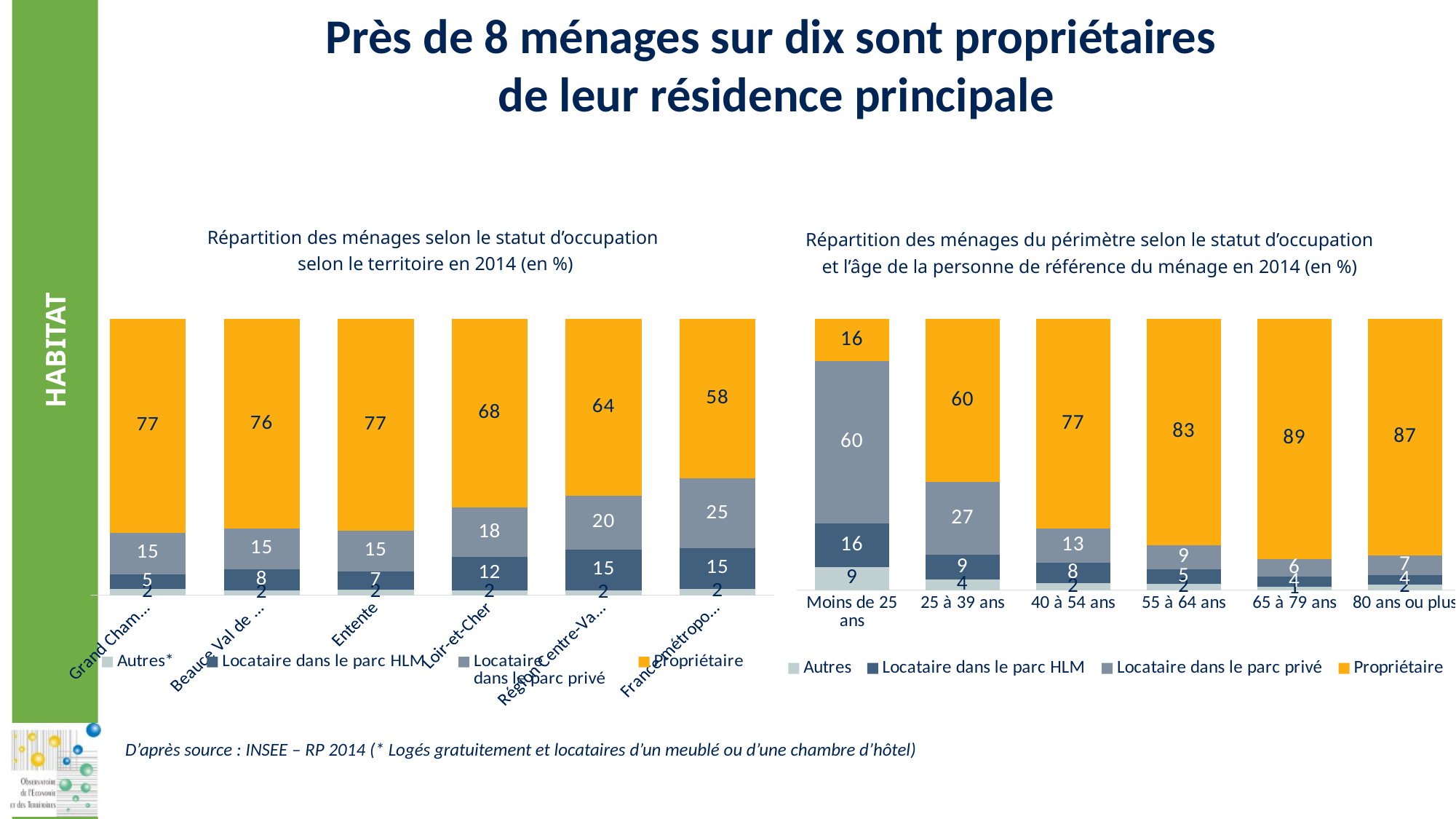
In the left chart (by territory), what is the Locataire dans le parc HLM value for Entente? 7 In the left chart (by territory), what is the Propriétaire value for Loir-et-Cher? 68 In the right chart (by age of the reference person), what is the Propriétaire value for 65 à 79 ans? 89 In the right chart (by age of the reference person), what is the Locataire dans le parc privé value for Moins de 25 ans? 60 In the right chart (by age of the reference person), what is the difference between the Propriétaire values for 55 à 64 ans and 25 à 39 ans? 23 How many age groups are shown in the right chart (by age of the reference person)? 6 How many series does the legend of the right chart (by age of the reference person) list? 4 What type of chart is the left chart (by territory)? Stacked bar chart In the right chart (by age of the reference person), is the Locataire dans le parc privé value larger for 25 à 39 ans or for 40 à 54 ans? 25 à 39 ans In the left chart (by territory), what is the difference between the Locataire dans le parc HLM values for Loir-et-Cher and Entente? 5 In the right chart (by age of the reference person), which age group has the highest Propriétaire value? 65 à 79 ans In the right chart (by age of the reference person), which age group has the lowest Propriétaire value? Moins de 25 ans